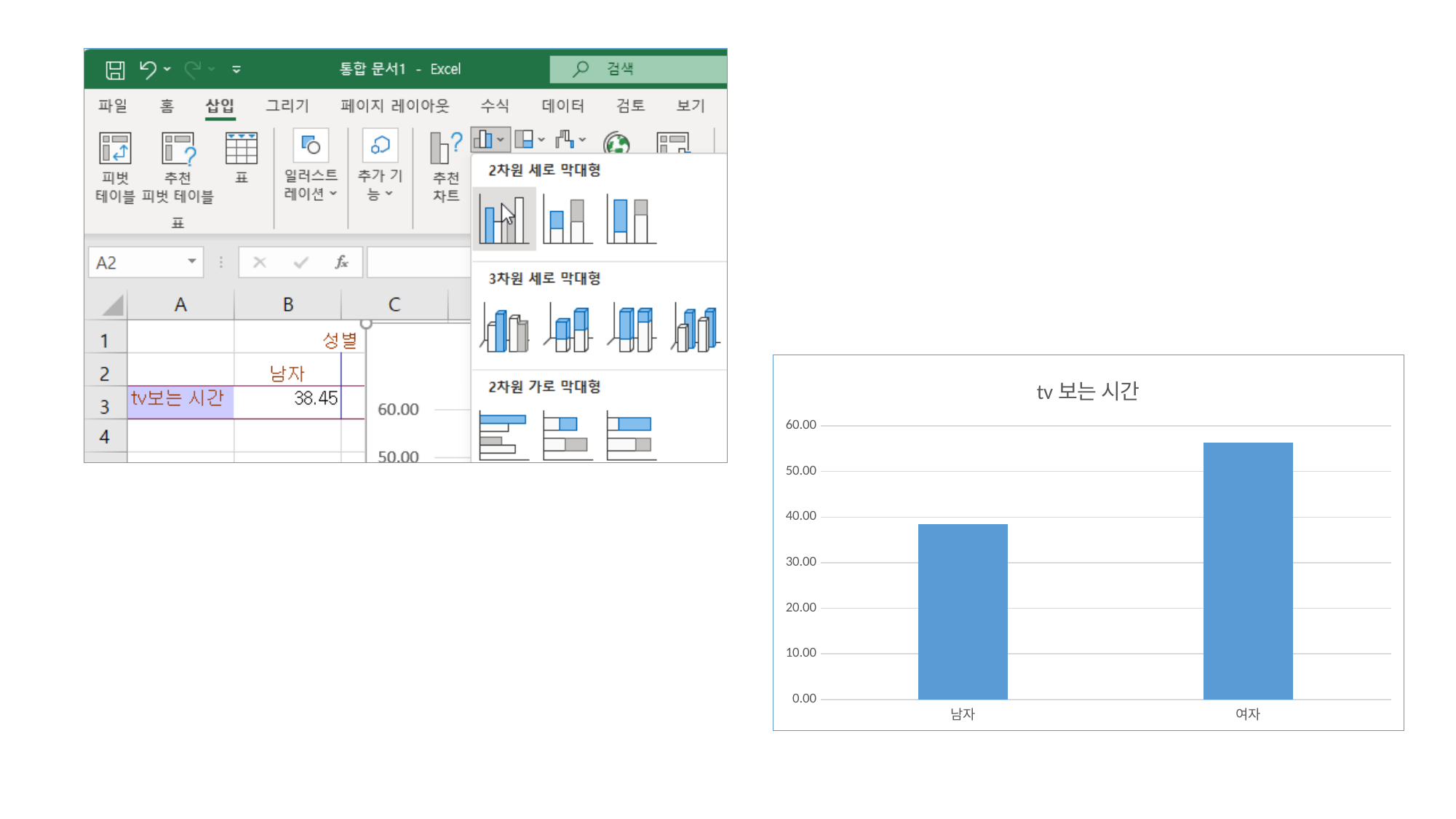
According to the spreadsheet cell shown on the slide, what is the value for 남자? 38.45 What kind of chart is shown on the slide? bar chart How many categories are plotted on the chart? 2 Which is larger, the value for 남자 or the value for 여자? 여자 What is the title of the chart? tv 보는 시간 What is the highest tick value shown on the chart's vertical axis? 60.00 Is the value for 여자 greater or less than 50.00? greater Is the value for 남자 greater or less than 40.00? less Which category has the lowest value on the chart? 남자 Which category has the highest value on the chart? 여자 Is the value for 남자 greater or less than 30.00? greater